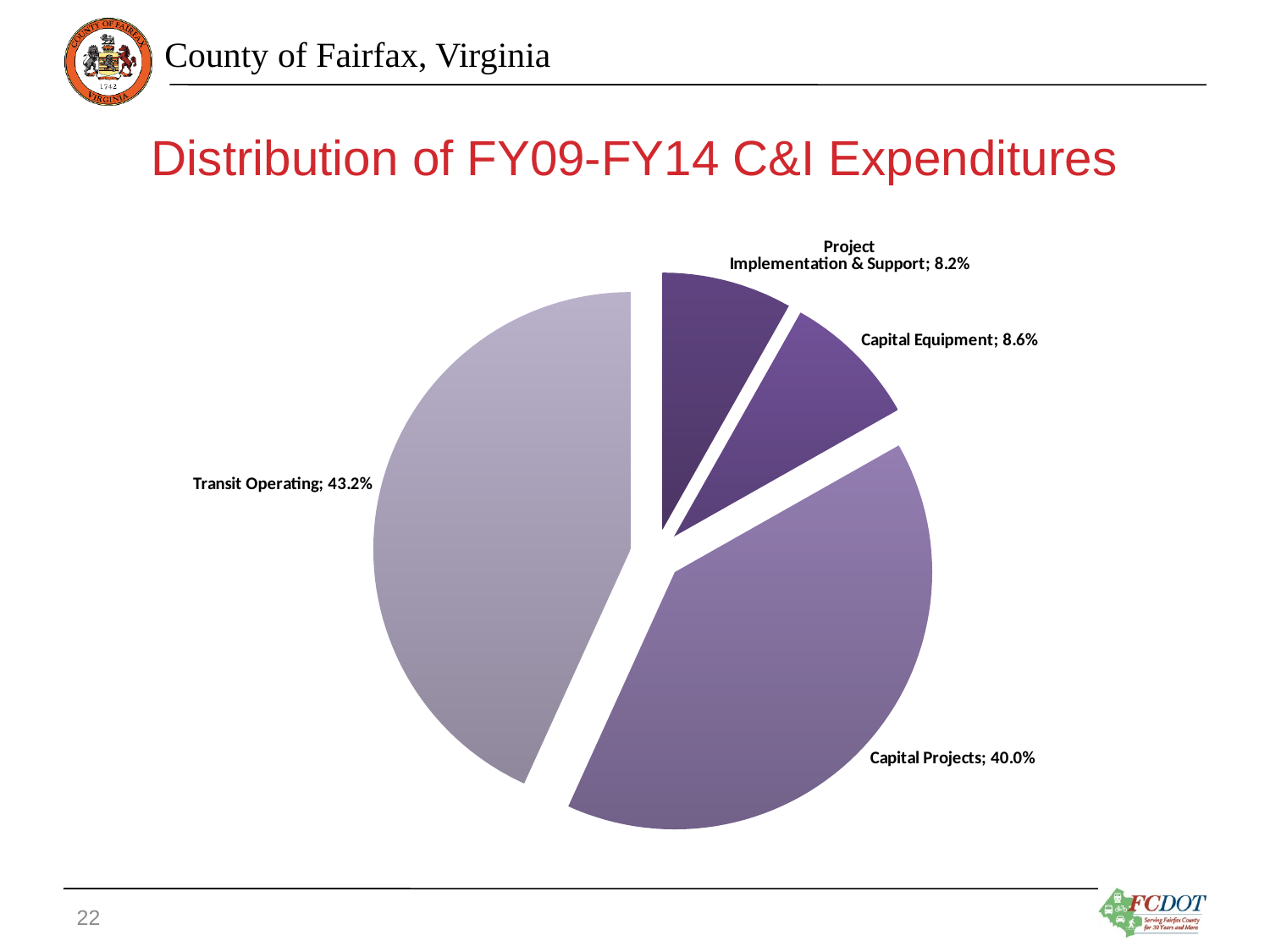
What is the title of the chart? Distribution of FY09-FY14 C&I Expenditures What share of FY09-FY14 C&I expenditures is Project Implementation & Support? 8.2% What is the difference in percentage points between Capital Equipment and Project Implementation & Support? 0.4 percentage points What share of FY09-FY14 C&I expenditures is Capital Projects? 40.0% How many slices does the pie chart have? 4 Which category has the largest share of the pie? Transit Operating Which is larger, the share for Capital Equipment or the share for Project Implementation & Support? Capital Equipment Which category has the smallest share of the pie? Project Implementation & Support What share of FY09-FY14 C&I expenditures is Capital Equipment? 8.6% What is the difference in percentage points between Transit Operating and Capital Projects? 3.2 percentage points What kind of chart is shown on the slide? pie chart What share of FY09-FY14 C&I expenditures is Transit Operating? 43.2%